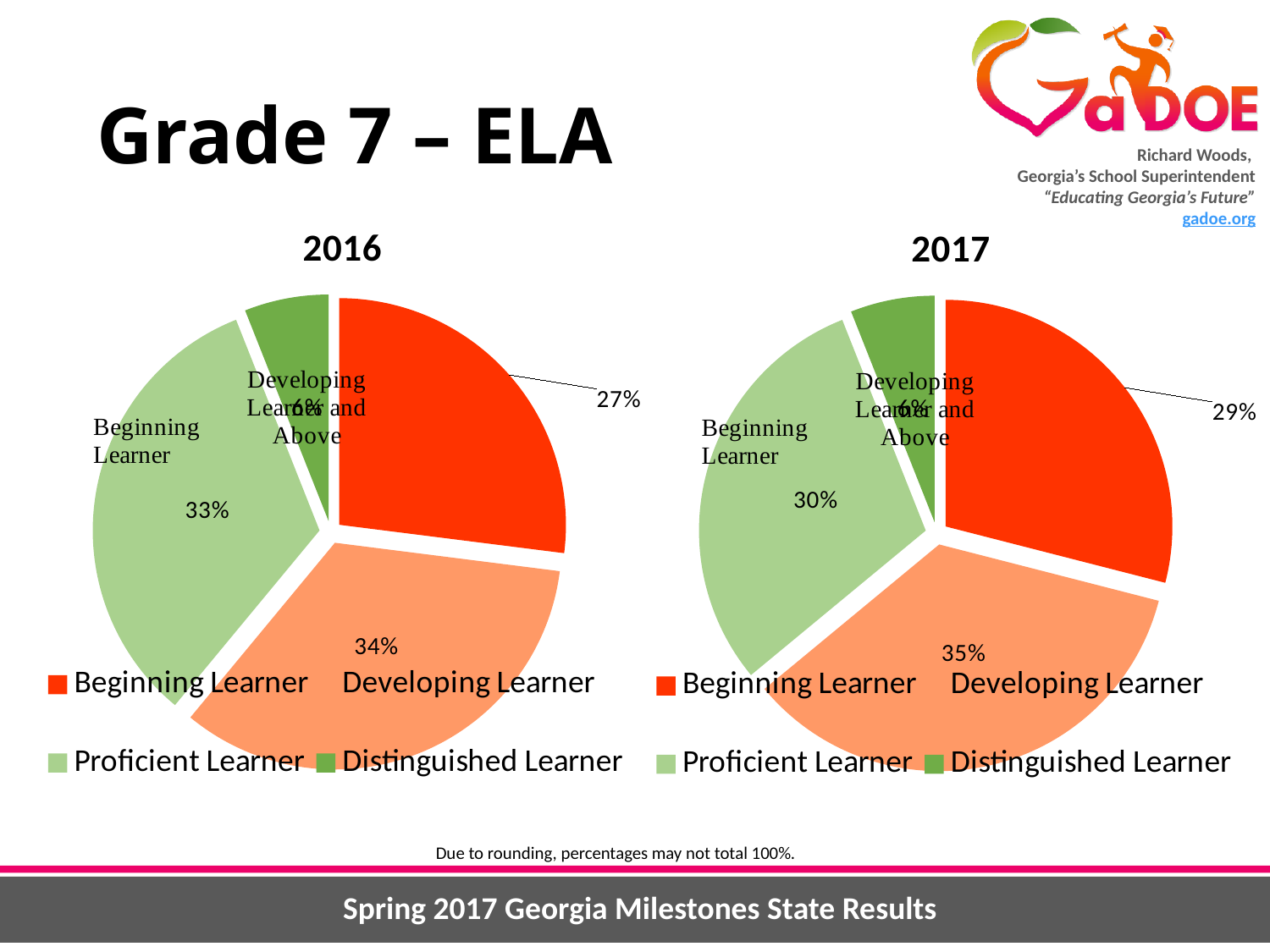
Which is larger in the 2016 chart: the Proficient Learner share or the Beginning Learner share? Proficient Learner In the 2017 chart, what percentage of students were Developing Learners? 35% In the 2016 chart, what percentage of students were Proficient Learners? 33% In the 2016 chart, which category has the smallest share? Distinguished Learner How many categories does the legend of the 2017 chart list? 4 In the 2016 chart, what percentage of students were Developing Learners? 34% In the 2016 chart, what percentage of students were Beginning Learners? 27% In the 2017 chart, what percentage of students were Beginning Learners? 29% In the 2017 chart, what percentage of students were Proficient Learners? 30% What type of chart is used for the 2016 data? pie chart In the 2017 chart, what is the difference in percentage points between Developing Learners and Beginning Learners? 6 percentage points In the 2017 chart, which category has the largest share? Developing Learner